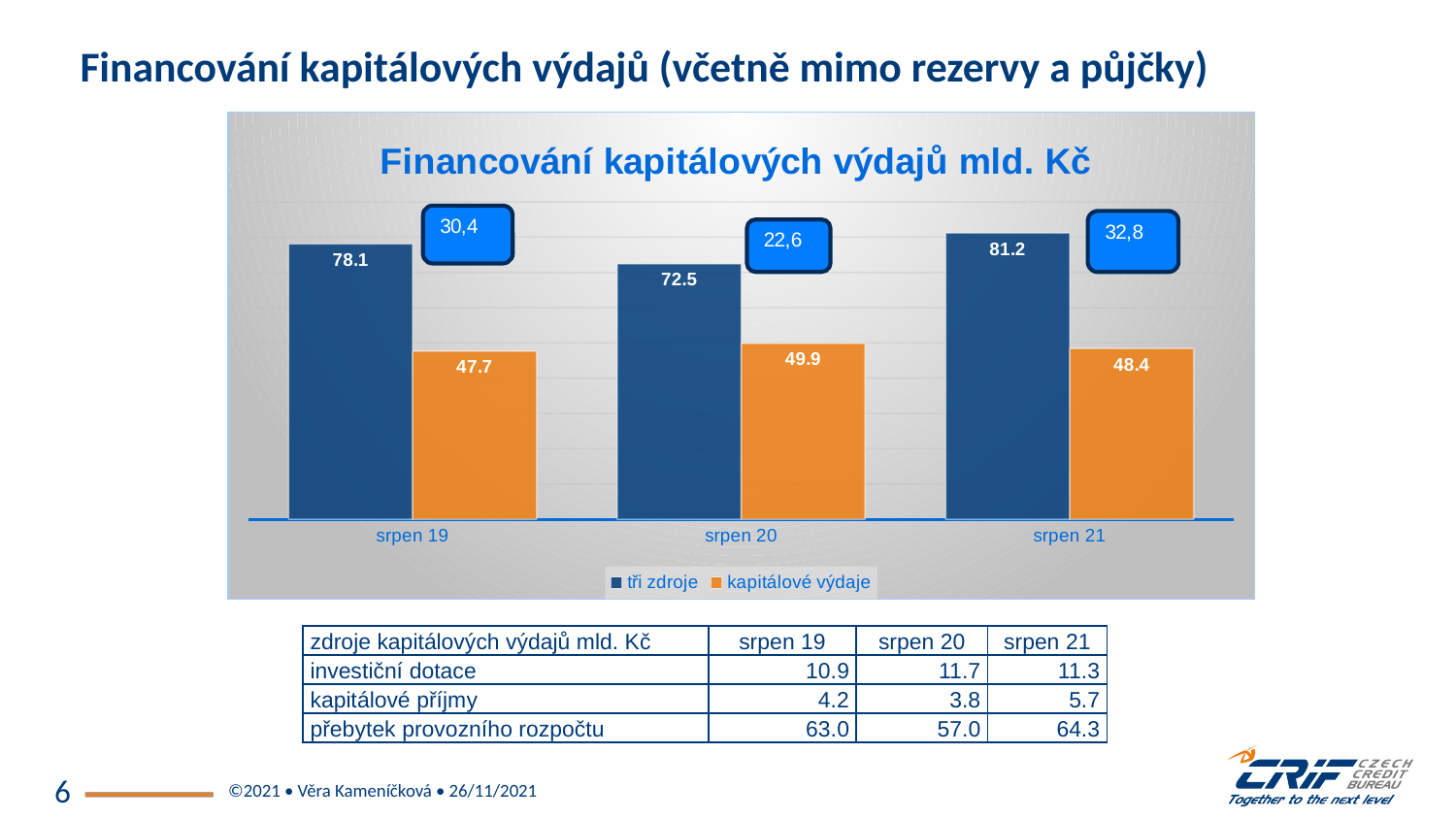
In which category is 'tři zdroje' lowest? srpen 20 In which category is 'kapitálové výdaje' lowest? srpen 19 What is the value of 'kapitálové výdaje' for srpen 20? 49.9 In which category is 'tři zdroje' highest? srpen 21 What is the value of 'kapitálové výdaje' for srpen 21? 48.4 What is the value of 'tři zdroje' for srpen 19? 78.1 How many categories are shown on the x axis? 3 What is the value of 'tři zdroje' for srpen 21? 81.2 Which is larger for srpen 20: 'tři zdroje' or 'kapitálové výdaje'? tři zdroje What type of chart is shown? bar chart What is the difference between 'tři zdroje' and 'kapitálové výdaje' for srpen 19? 30.4 How many series does the legend list? 2